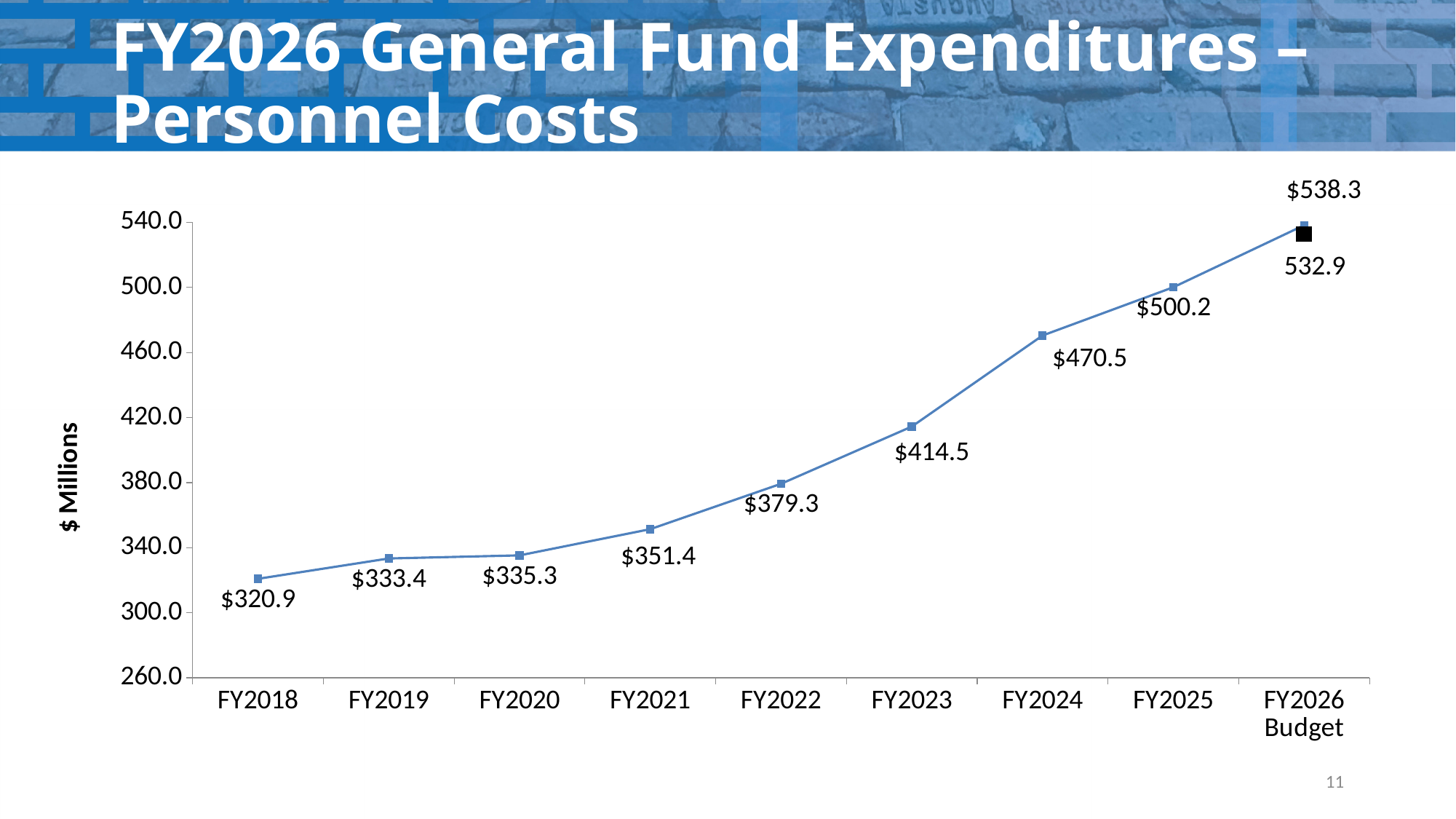
What is the difference between the FY2025 value and the FY2024 value? $29.7 How many fiscal years are plotted on the x axis? 9 What is the value for FY2024? $470.5 What is the value for FY2025? $500.2 Do the values rise or fall from FY2018 to FY2026 Budget? Rise What is the value for FY2018? $320.9 What is the value for FY2021? $351.4 Which is larger, the value for FY2019 or the value for FY2020? FY2020 Which fiscal year has the lowest value on the chart? FY2018 Which fiscal year has the highest value on the chart? FY2026 Budget What is the difference between the FY2023 value and the FY2022 value? $35.2 What kind of chart is shown on the slide? Line chart